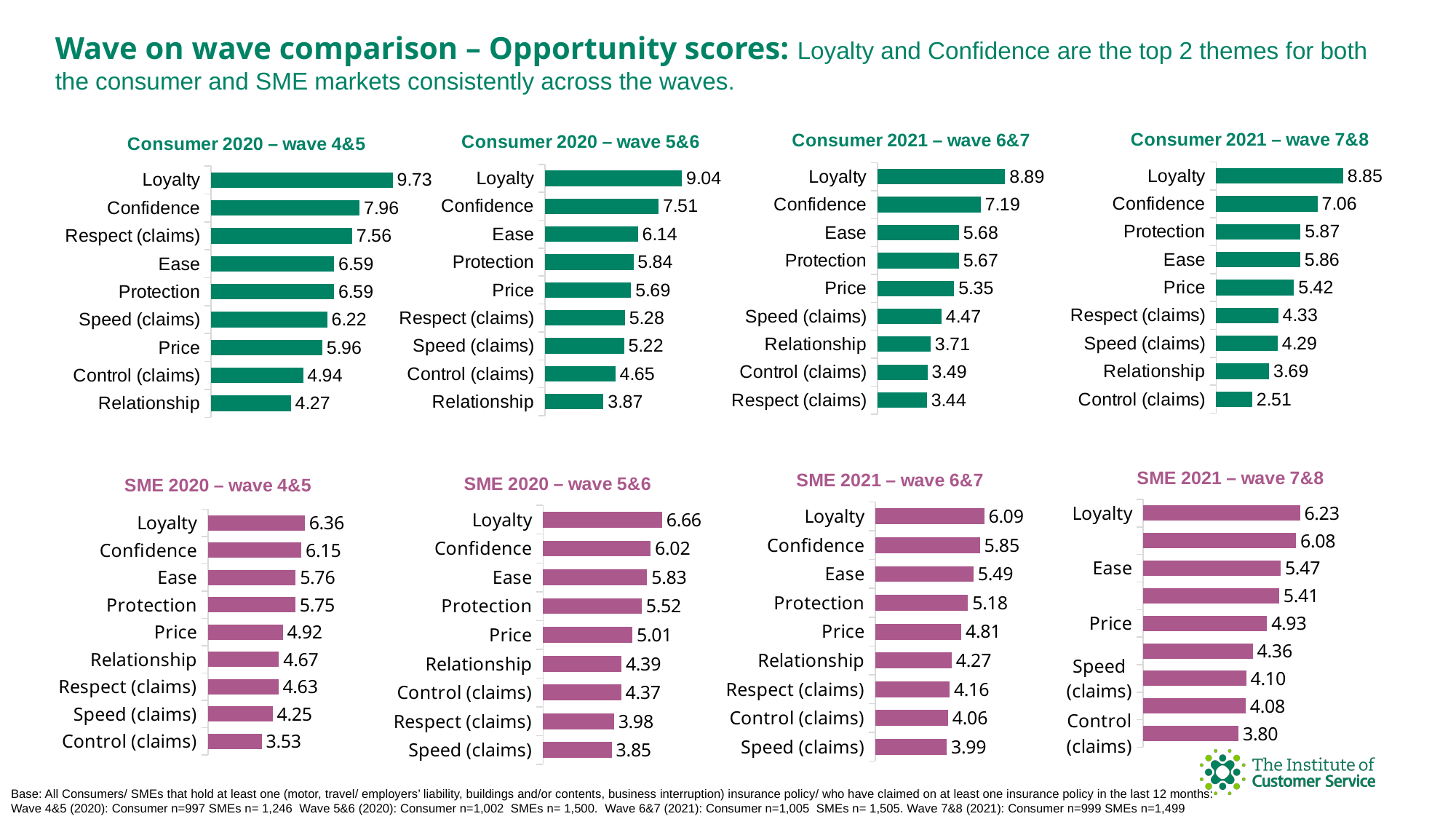
How many themes are plotted in the Consumer 2021 – wave 7&8 chart? 9 In the Consumer 2021 – wave 6&7 chart, which theme has the highest score? Loyalty In the Consumer 2021 – wave 7&8 chart, what is the value for Control (claims)? 2.51 In the SME 2021 – wave 6&7 chart, what is the difference between the Loyalty and Speed (claims) scores? 2.10 In the Consumer 2020 – wave 4&5 chart, what is the value for Loyalty? 9.73 In the SME 2021 – wave 6&7 chart, which is larger, Ease or Protection? Ease How many charts are shown on the slide? 8 In the SME 2020 – wave 4&5 chart, which theme has the lowest score? Control (claims) In the SME 2020 – wave 5&6 chart, what is the value for Price? 5.01 In the Consumer 2020 – wave 5&6 chart, what is the difference between the Loyalty and Confidence scores? 1.53 What type of chart is used for the Consumer 2020 – wave 4&5 data? Bar chart In the SME 2021 – wave 7&8 chart, what is the value for Loyalty? 6.23